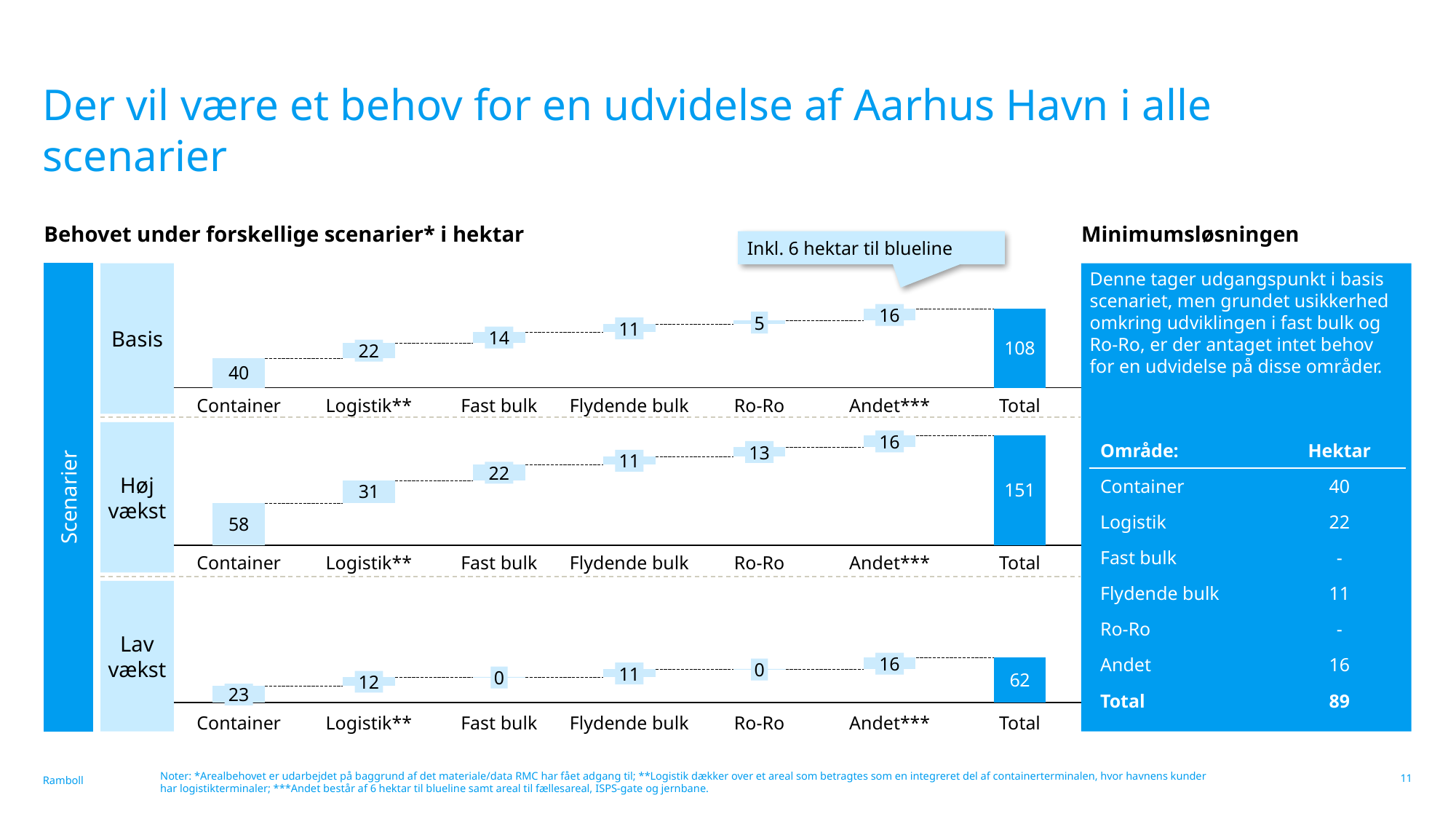
In the Høj vækst chart, what is the value for Logistik**? 31 How many categories are labelled on the x axis of the Basis chart? 7 What is the difference between the Total in the Høj vækst chart and the Total in the Basis chart? 43 In the Basis chart, which category has the lowest value? Ro-Ro In the Lav vækst chart, what is the Total value? 62 In the Basis chart, which category (excluding Total) has the highest value? Container How many scenario charts are shown on the slide? 3 In the Lav vækst chart, what is the difference between Container and Logistik**? 11 Which is larger: Ro-Ro in the Høj vækst chart or Ro-Ro in the Basis chart? Høj vækst In the Høj vækst chart, which category (excluding Total) has the lowest value? Flydende bulk In the Basis chart, what is the value for Container? 40 In the Høj vækst chart, what is the Total value? 151